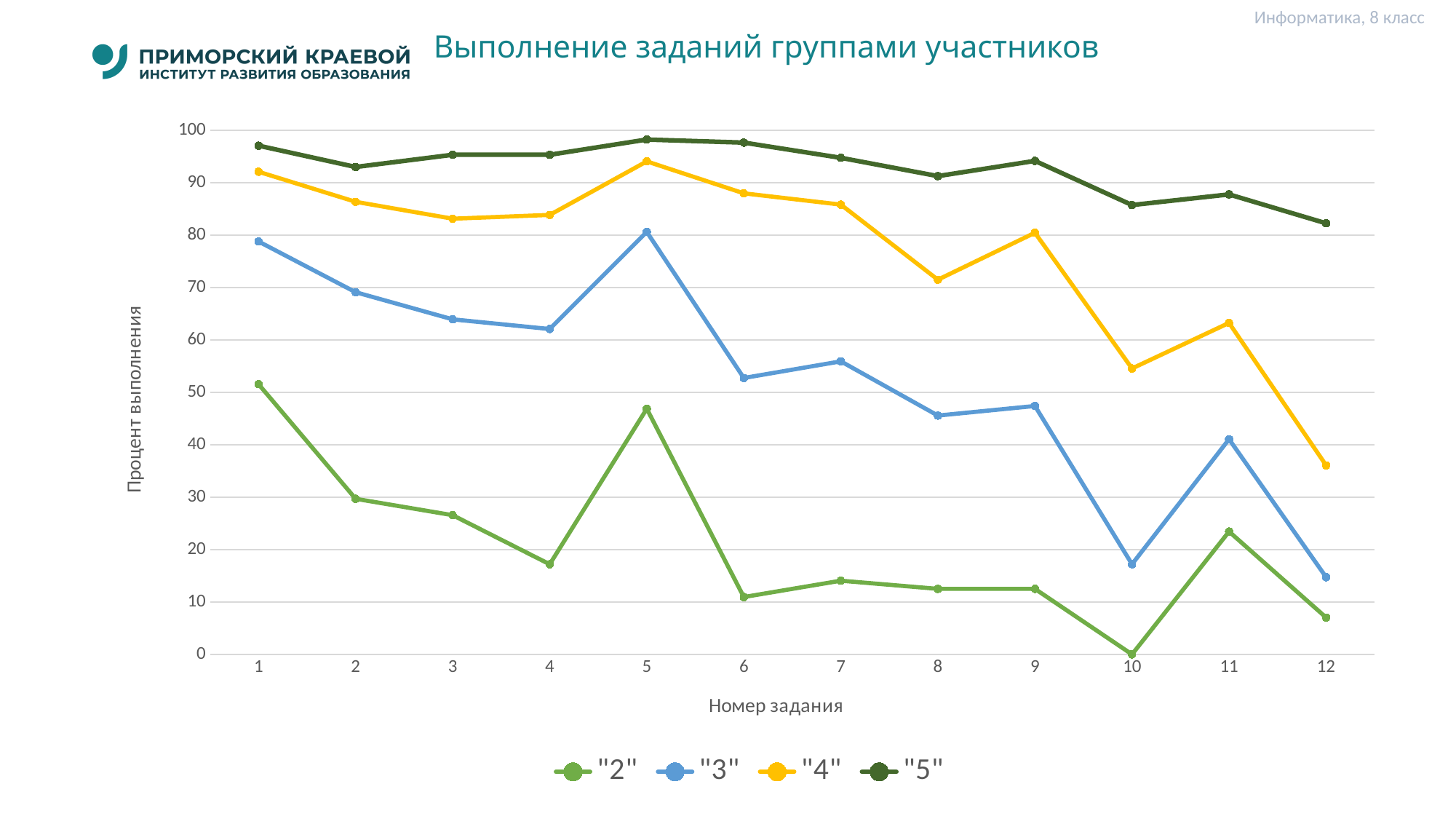
For which task number is the value of series "2" highest? 1 For which task number is the value of series "4" lowest? 12 Which series has the larger value for task 11, "3" or "2"? "3" Is the value of series "4" for task 12 greater or less than 40? less How many task numbers are plotted along the x axis? 12 For which task number is the value of series "5" lowest? 12 Does the value of series "4" generally rise or fall from task 1 to task 12? fall How many series does the legend list? 4 What is the title of the chart? Выполнение заданий группами участников For which task number is the value of series "2" lowest? 10 What kind of chart is shown on the slide? line chart